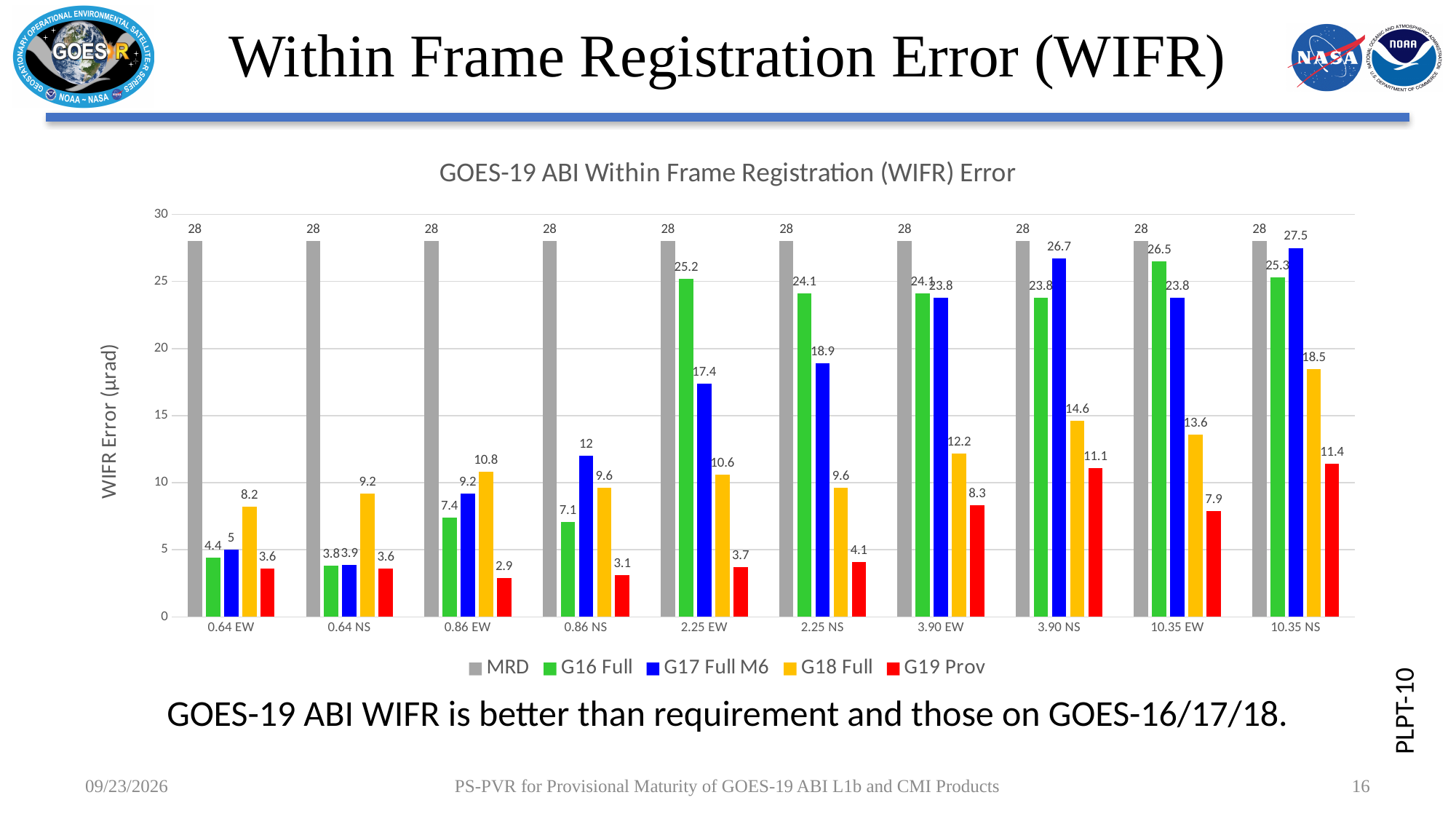
Which category has the highest G19 Prov value? 10.35 NS Which is larger for 10.35 EW, the G16 Full value or the G17 Full M6 value? G16 Full Which category has the lowest G19 Prov value? 0.86 EW How many categories are shown on the x axis? 10 What is the G19 Prov value for 10.35 NS? 11.4 Is the G18 Full value for 3.90 NS greater or less than 10? greater What is the difference between the MRD value and the G19 Prov value for 2.25 EW? 24.3 What is the G18 Full value for 0.86 EW? 10.8 How many series does the legend list? 5 What is the G17 Full M6 value for 3.90 NS? 26.7 What kind of chart is shown on the slide? Bar chart What is the title of the chart? GOES-19 ABI Within Frame Registration (WIFR) Error